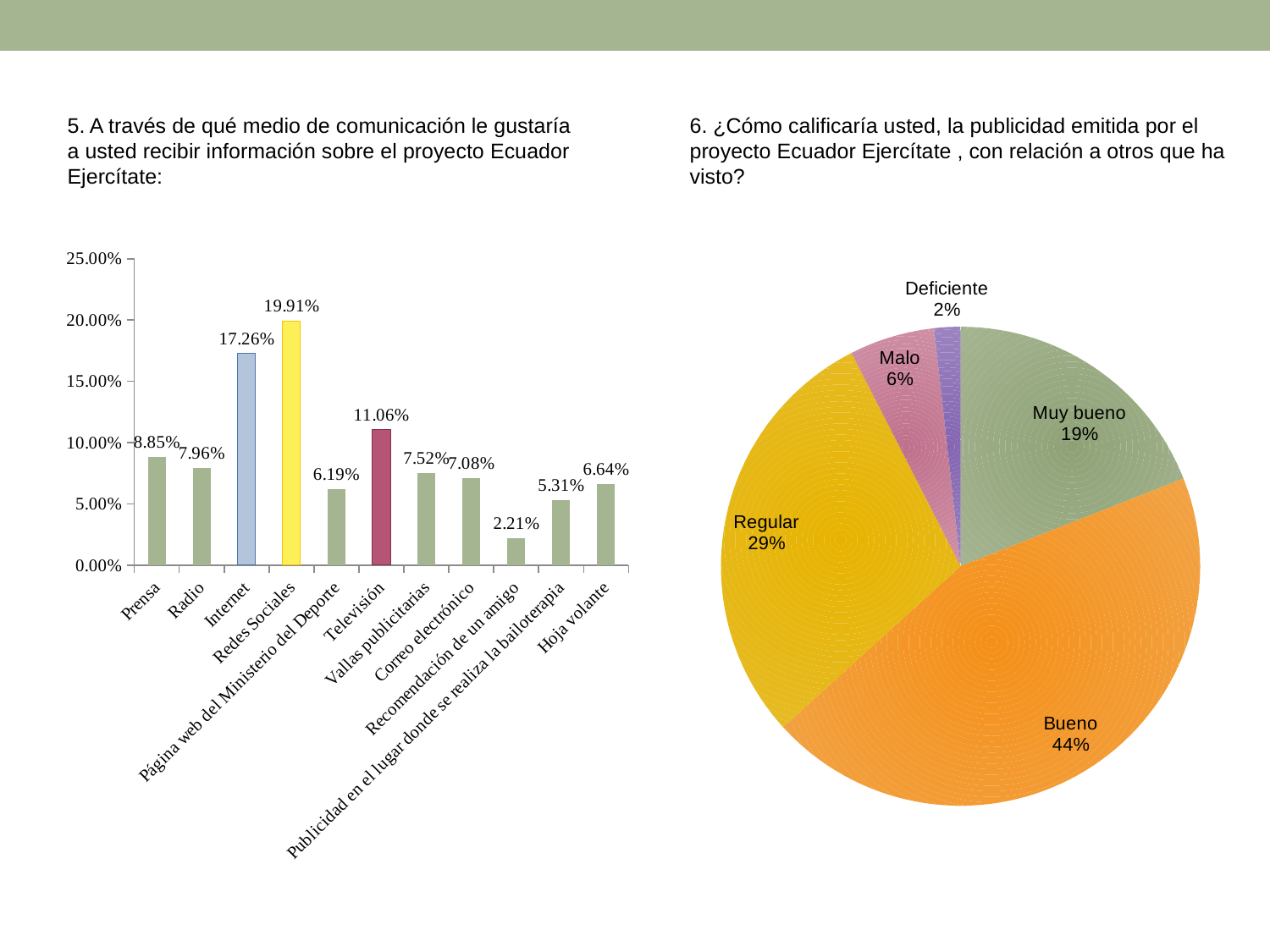
In the bar chart on the left, which category has the lowest value? Recomendación de un amigo In the bar chart on the left, which is larger, the value for Prensa or the value for Radio? Prensa In the pie chart on the right, what share does Bueno have? 44% In the bar chart on the left, what is the value for Televisión? 11.06% In the bar chart on the left, what is the difference between the values for Redes Sociales and Internet? 2.65% In the bar chart on the left, what is the value for Redes Sociales? 19.91% In the bar chart on the left, how many categories are shown on the x axis? 11 What kind of chart is shown on the left side of the slide? Bar chart In the pie chart on the right, what is the combined share of Regular and Malo? 35% In the bar chart on the left, which category has the highest value? Redes Sociales In the pie chart on the right, how many slices are there? 5 In the pie chart on the right, which category has the smallest slice? Deficiente